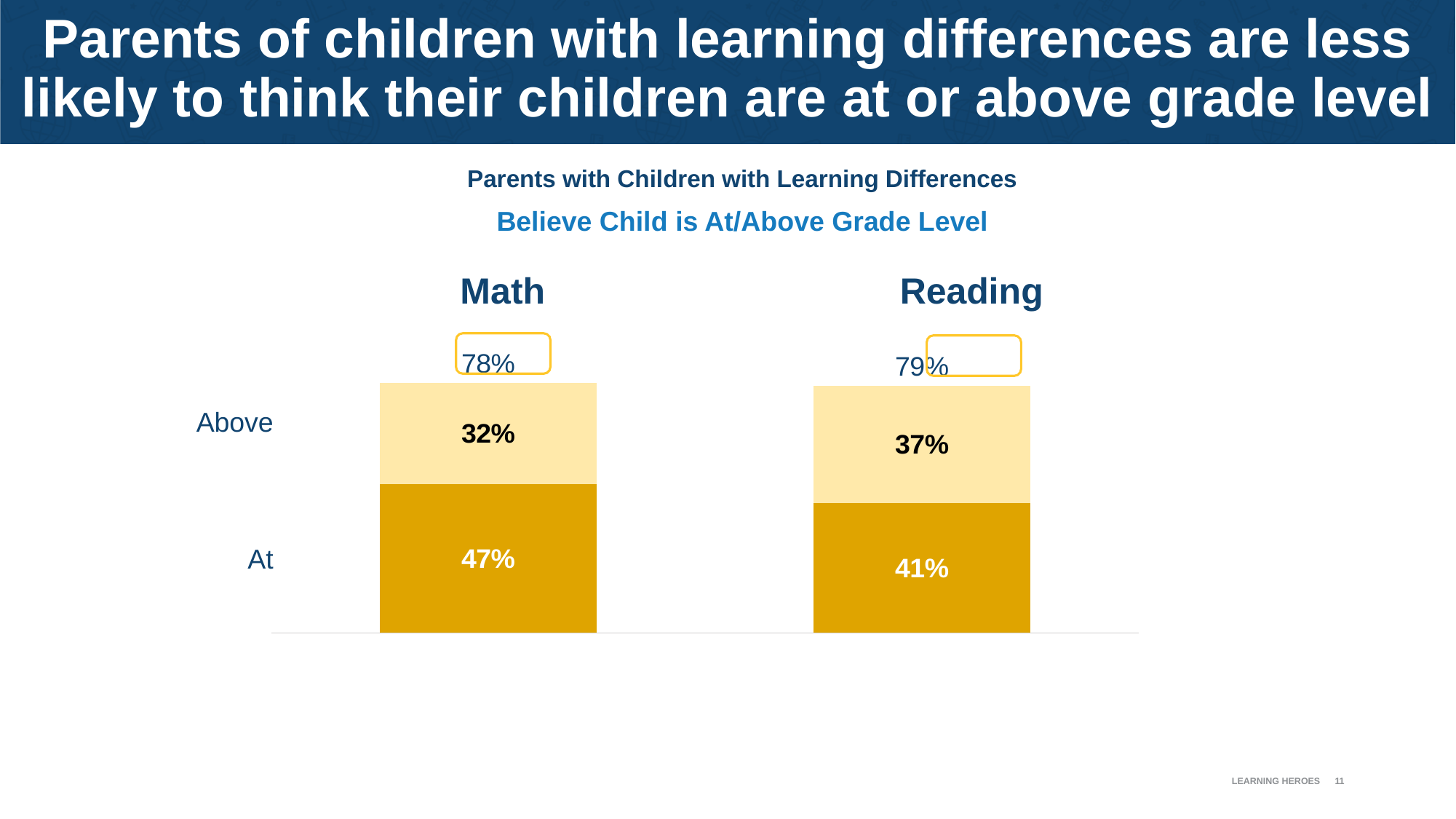
What percentage of parents of children with learning differences believe their child is above grade level in Reading? 37% What percentage of parents of children with learning differences believe their child is at grade level in Math? 47% How many subjects (bars) are shown in the chart? 2 What is the difference between the 'Above' grade level percentages for Reading and Math? 5% Which subject has the larger 'At' grade level segment, Math or Reading? Math What is the labelled total share of parents who believe their child is at or above grade level in Math? 78% Which subject has the larger 'Above' grade level segment, Math or Reading? Reading What is the difference between the 'At' grade level percentages for Math and Reading? 6% What percentage of parents of children with learning differences believe their child is at grade level in Reading? 41% What type of chart is used on this slide? Stacked bar chart What is the labelled total share of parents who believe their child is at or above grade level in Reading? 79% What percentage of parents of children with learning differences believe their child is above grade level in Math? 32%